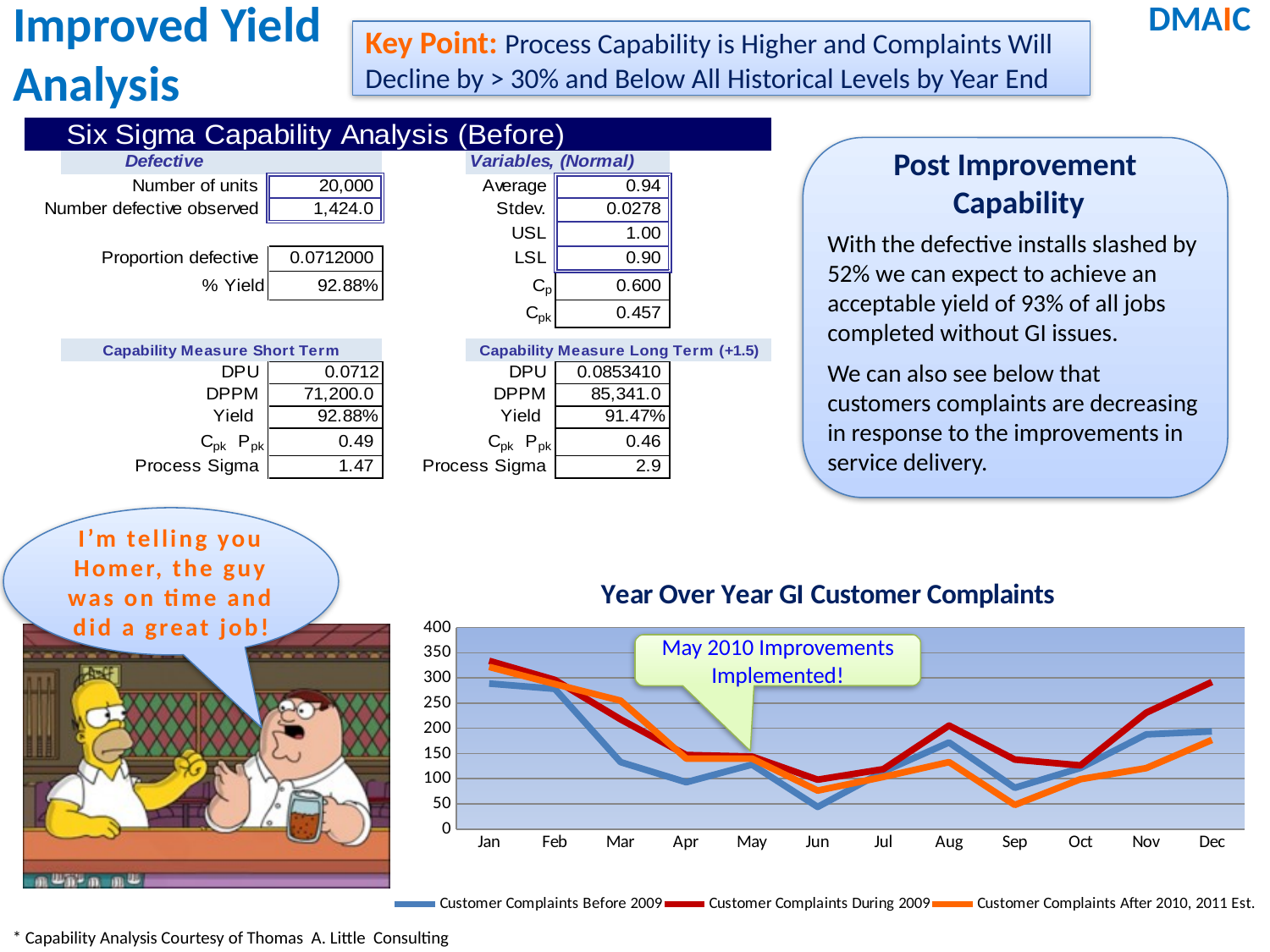
In the "Year Over Year GI Customer Complaints" chart, which is larger in Dec: Customer Complaints During 2009 or Customer Complaints After 2010, 2011 Est.? Customer Complaints During 2009 In the "Year Over Year GI Customer Complaints" chart, is the value for Customer Complaints Before 2009 in Sep greater or less than 100? less What type of chart is the "Year Over Year GI Customer Complaints" chart? line chart How many months are shown on the x axis of the "Year Over Year GI Customer Complaints" chart? 12 How many series does the legend of the "Year Over Year GI Customer Complaints" chart list? 3 What does the callout annotation on the "Year Over Year GI Customer Complaints" chart say? May 2010 Improvements Implemented! In the "Year Over Year GI Customer Complaints" chart, do the values for Customer Complaints Before 2009 rise or fall from Jan to Jun? fall In the "Year Over Year GI Customer Complaints" chart, which month has the lowest value for Customer Complaints Before 2009? Jun In the "Year Over Year GI Customer Complaints" chart, which month has the lowest value for Customer Complaints After 2010, 2011 Est.? Sep In the "Year Over Year GI Customer Complaints" chart, is the value for Customer Complaints During 2009 in Jan greater or less than 300? greater In the "Year Over Year GI Customer Complaints" chart, is the value for Customer Complaints During 2009 in Dec greater or less than 250? greater In the "Year Over Year GI Customer Complaints" chart, which month has the highest value for Customer Complaints During 2009? Jan